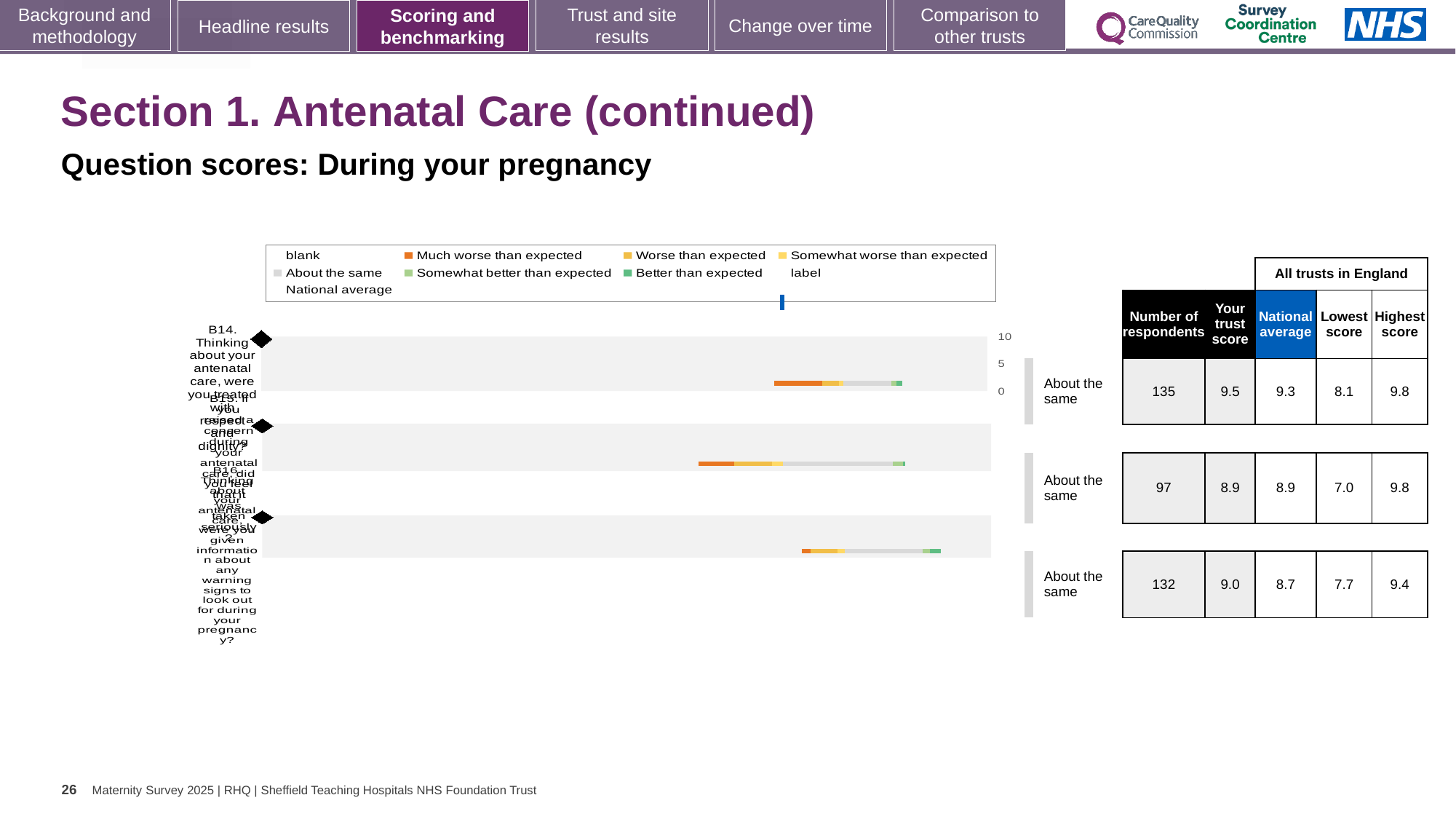
In the table beside the chart, what is the national average for the first question (B14)? 9.3 What is the highest value shown on the chart's score axis? 10 Which of the three questions in the table has the highest trust score? B14 (first row), 9.5 Which colour does the legend use for 'Much worse than expected'? orange In the table beside the chart, how many respondents answered the first question (B14)? 135 How many question bars are plotted in the chart? 3 For the first question (B14), how much higher is the trust score than the national average? 0.2 What benchmark category is shown for all three questions on the slide? About the same For the second question in the table, is the trust score larger than the national average, or are they equal? equal (8.9) What is the lowest 'Lowest score' value shown in the table? 7.0 What kind of chart is shown on the slide? bar chart In the table beside the chart, what is the trust score for the first question (B14, treated with respect and dignity)? 9.5